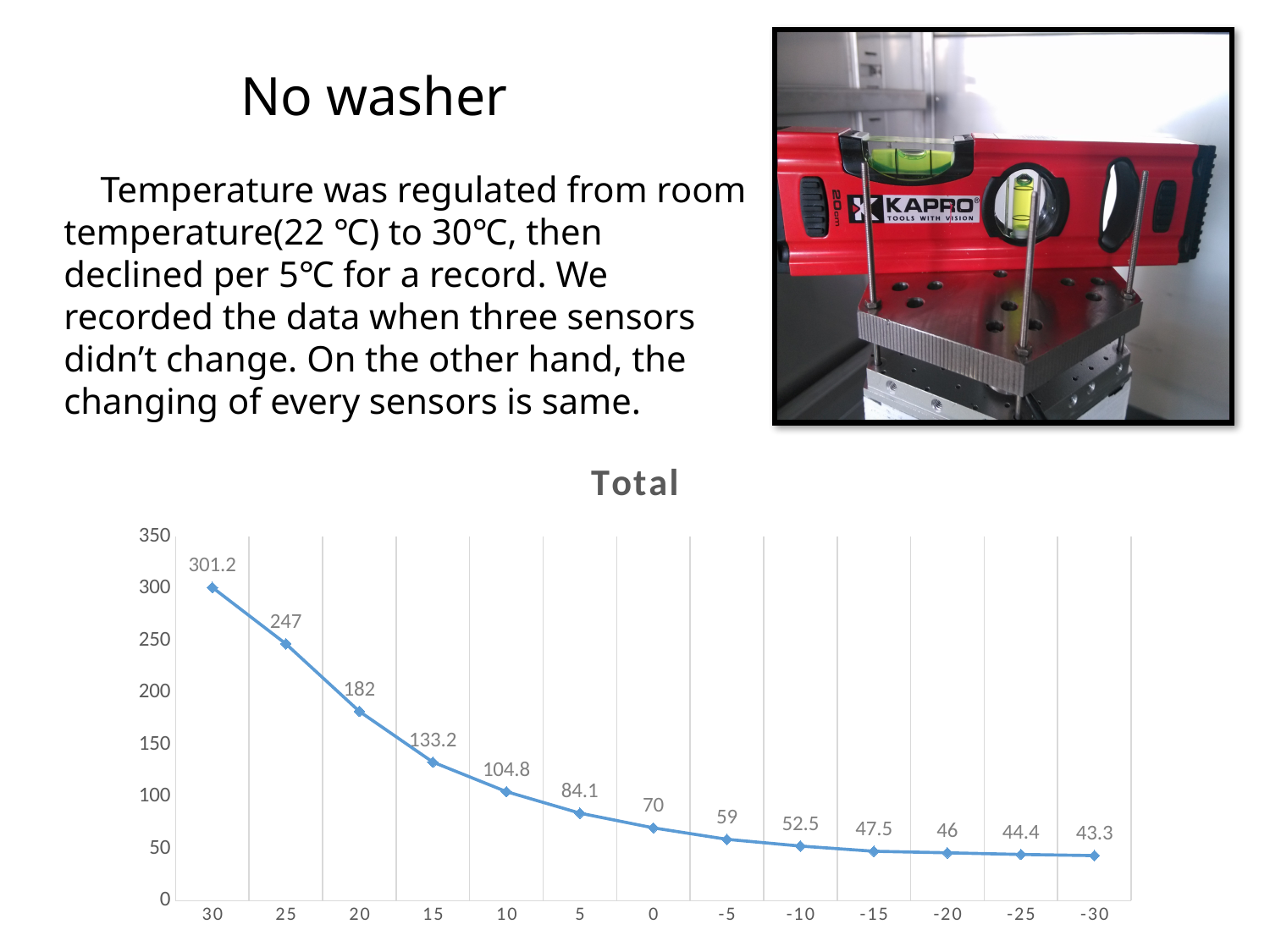
What is the value at -30 on the x axis? 43.3 What is the value at 0 on the x axis? 70 What is the value at 15 on the x axis? 133.2 At which x-axis category is the value highest? 30 How many data points are plotted on the chart? 13 What is the value at 30 on the x axis? 301.2 At which x-axis category is the value lowest? -30 What is the title of the chart? Total Do the values rise or fall moving from left to right along the x axis? Fall What kind of chart is shown on the slide? Line chart Which is larger, the value at 10 or the value at 5? 10 What is the difference between the values at 30 and 25? 54.2